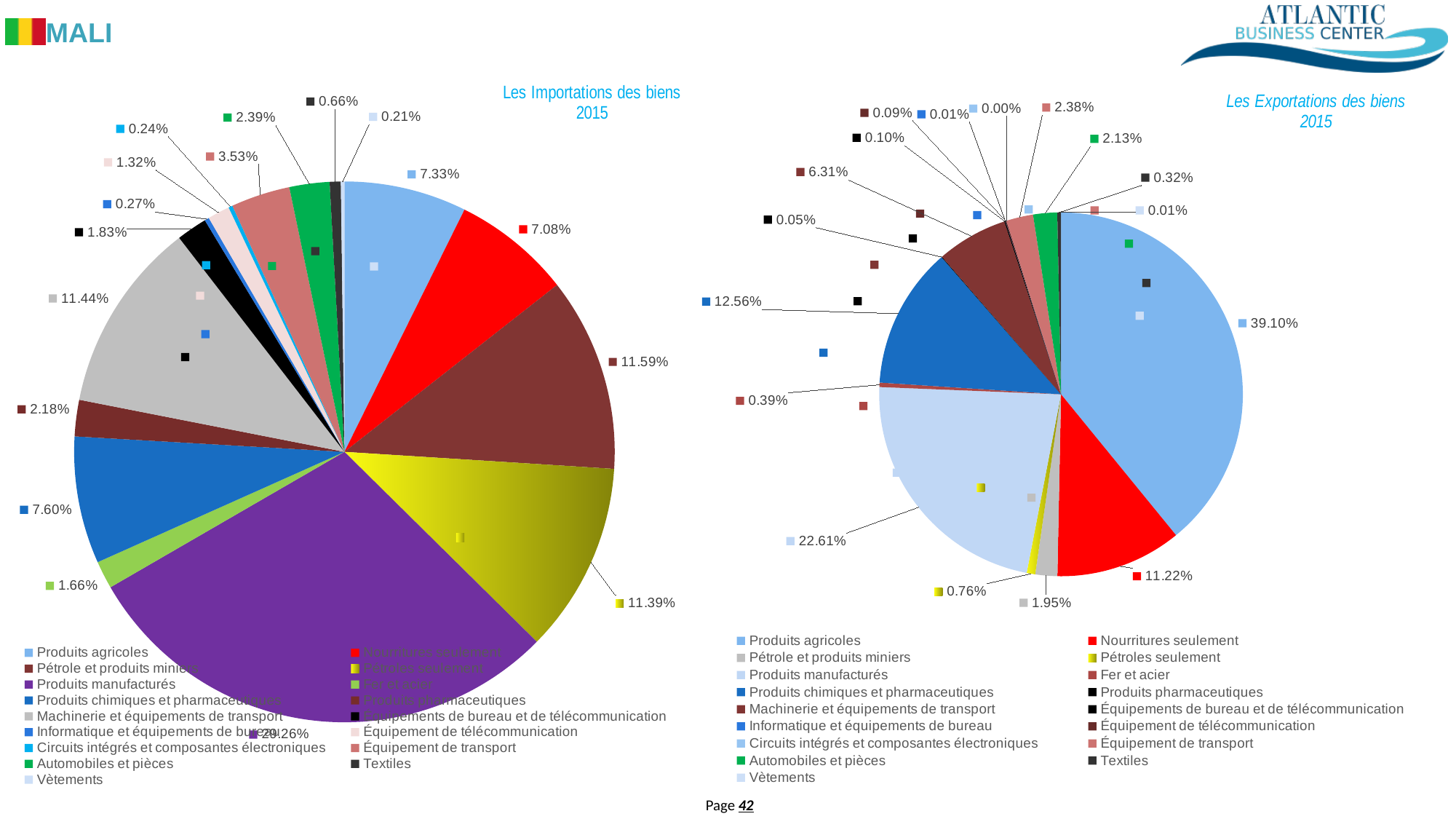
In the 'Les Exportations des biens 2015' chart, what is the value for Produits chimiques et pharmaceutiques? 12.56% How many categories does the legend of the 'Les Importations des biens 2015' chart list? 17 In the 'Les Importations des biens 2015' chart, what is the value for Machinerie et équipements de transport? 11.44% In the 'Les Exportations des biens 2015' chart, what is the difference between Produits agricoles and Produits manufacturés? 16.49% In the 'Les Importations des biens 2015' chart, which is larger: Pétrole et produits miniers or Pétroles seulement? Pétrole et produits miniers What kind of charts are shown on the slide? Pie charts What is the title of the chart on the right side of the slide? Les Exportations des biens 2015 In the 'Les Exportations des biens 2015' chart, which is larger: Nourritures seulement or Machinerie et équipements de transport? Nourritures seulement In the 'Les Importations des biens 2015' chart, what share do Produits manufacturés have? 29.26% In the 'Les Exportations des biens 2015' chart, what share do Produits agricoles have? 39.10% In the 'Les Exportations des biens 2015' chart, which category has the largest share? Produits agricoles In the 'Les Importations des biens 2015' chart, which category has the largest share? Produits manufacturés